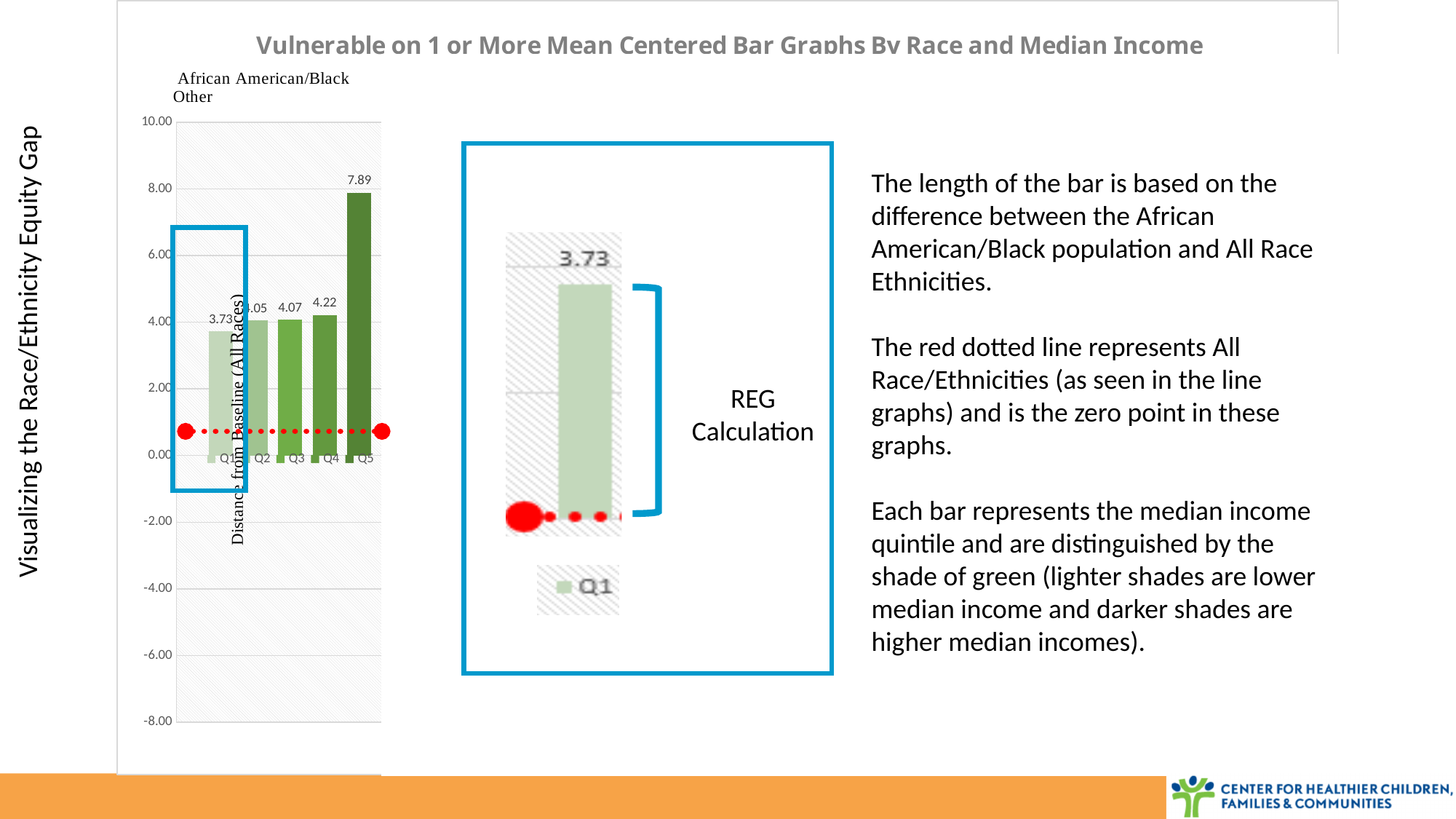
Which is larger, the value for Q5 or the value for Q4? Q5 Which quintile has the lowest bar? Q1 What is the value of the Q5 bar? 7.89 What is the difference between the Q4 and Q3 values? 0.15 How many quintile bars are plotted in the chart? 5 What is the value of the Q1 bar? 3.73 Which quintile has the highest bar? Q5 What is the value of the Q4 bar? 4.22 What is the value of the Q3 bar? 4.07 What is the difference between the Q5 and Q1 values? 4.16 What kind of chart is shown on the slide? bar chart Do the bar values rise or fall from Q1 to Q5? rise